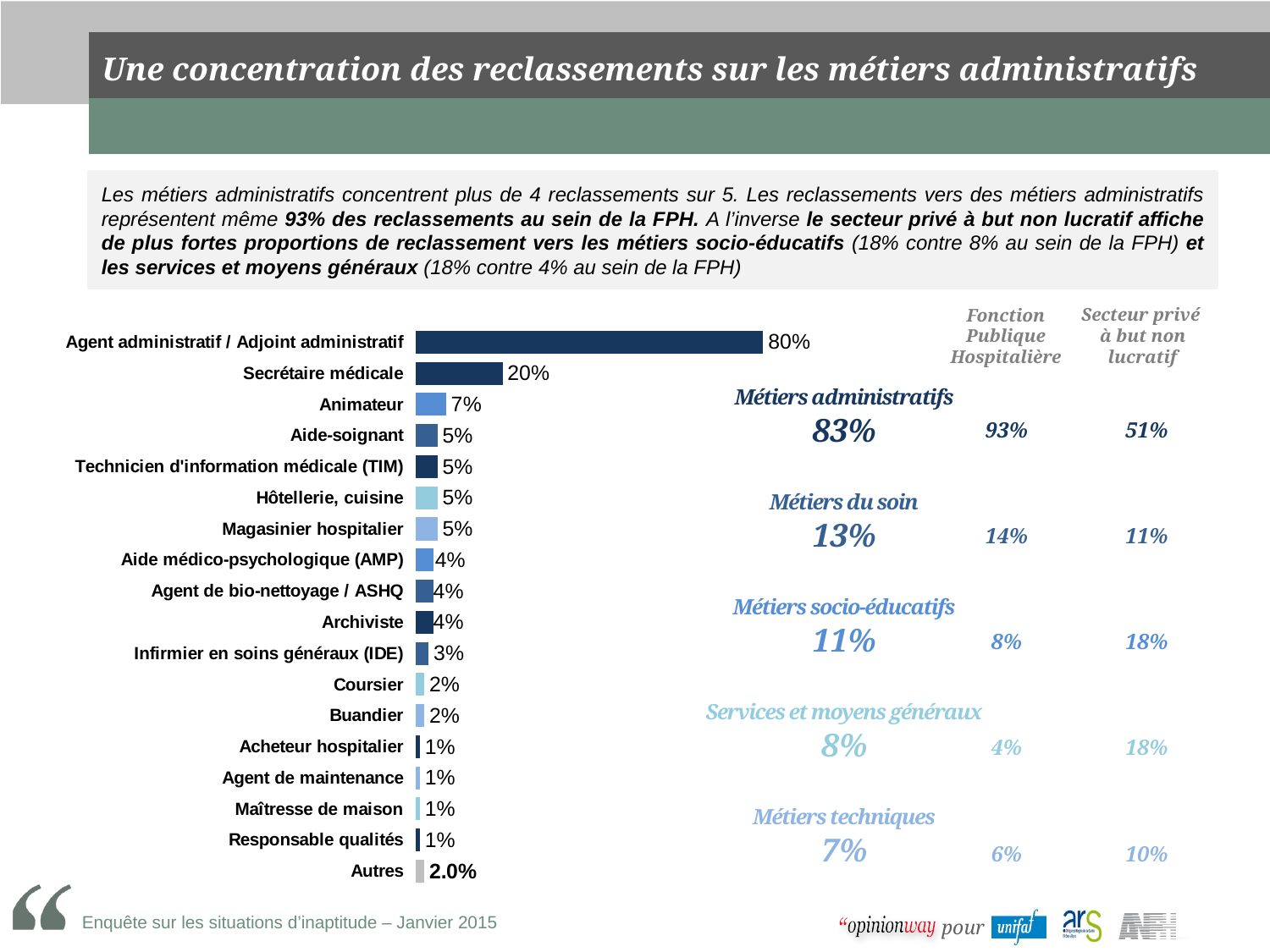
What is the difference between the values for Agent administratif / Adjoint administratif and Secrétaire médicale? 60 percentage points What is the value for Magasinier hospitalier? 5% What is the value for Animateur? 7% What is the value for Agent administratif / Adjoint administratif? 80% What kind of chart is shown on the slide? bar chart How many categories are shown in the bar chart? 18 What is the value for Infirmier en soins généraux (IDE)? 3% What is the value for Autres? 2.0% Which category has the highest value in the bar chart? Agent administratif / Adjoint administratif Which is larger, the value for Archiviste or the value for Coursier? Archiviste What is the value for Secrétaire médicale? 20% Which is larger, the value for Animateur or the value for Aide-soignant? Animateur